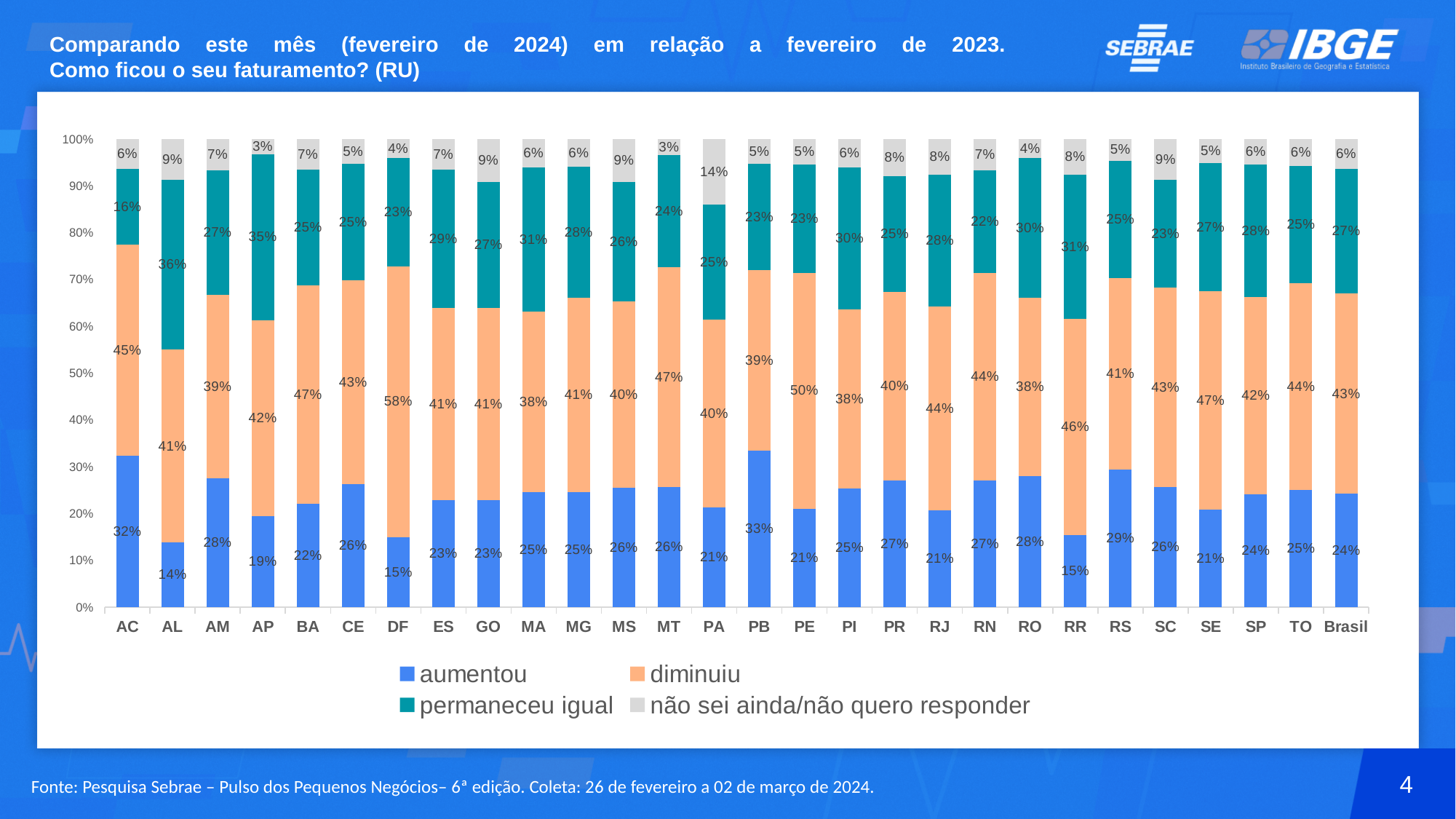
What kind of chart is shown on the slide? Stacked bar chart Which is larger, the "aumentou" value for AC or for RS? AC What is the "aumentou" value for Brasil? 24% Which state has the lowest "aumentou" share? AL What is the "permaneceu igual" value for AL? 36% How many categories are shown on the x axis? 28 What is the difference between the "diminuiu" values for DF and PE? 8% How many series does the legend list? 4 Which colour represents the "permaneceu igual" series? Teal (dark green) What percentage of respondents in DF answered "diminuiu"? 58% Which category has the highest "não sei ainda/não quero responder" share? PA Which state has the highest "aumentou" share? PB